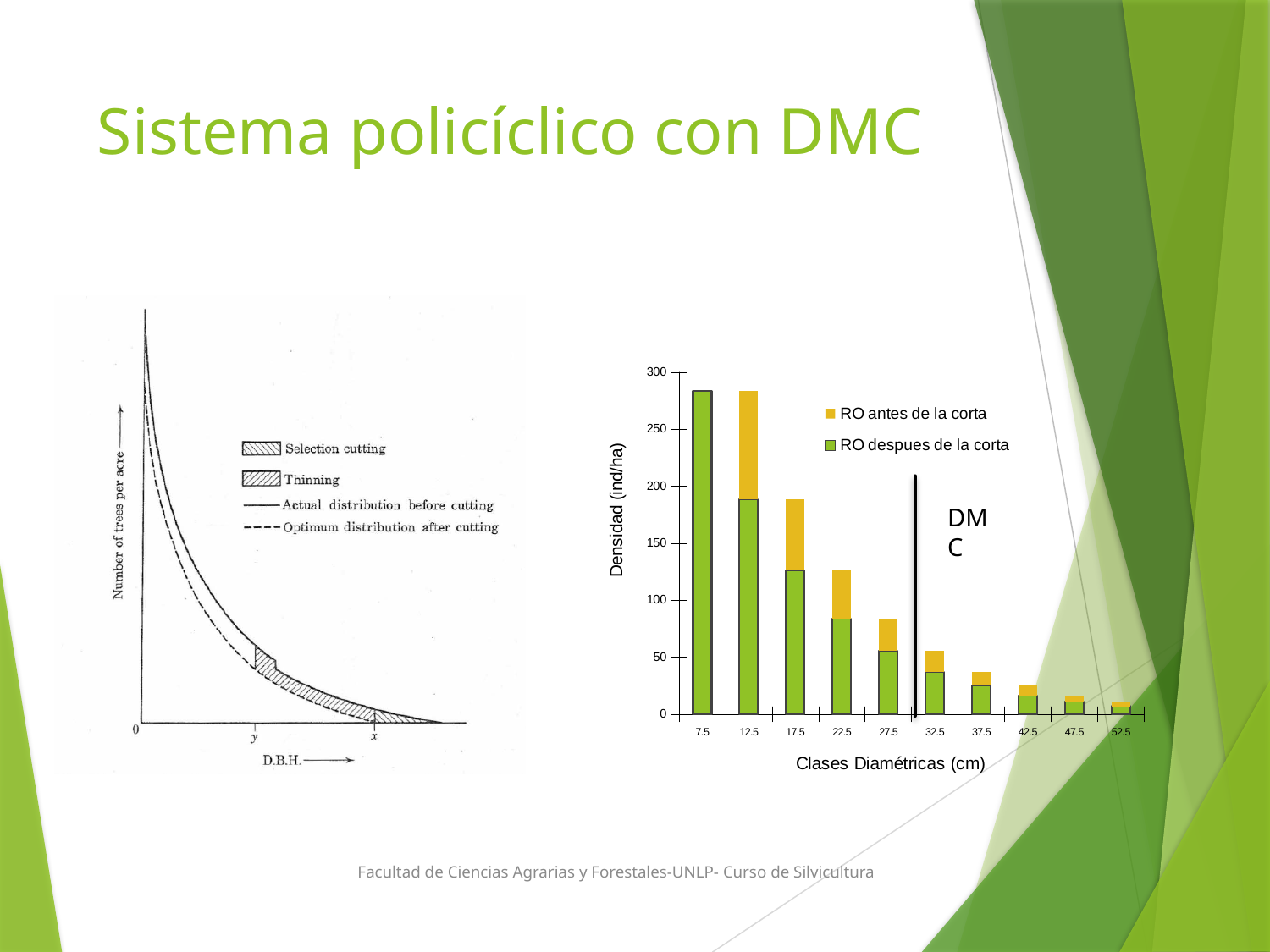
In the right-hand bar chart, is the value of RO despues de la corta for class 32.5 greater or less than 50? less What kind of chart is the chart on the right of the slide? bar chart In the right-hand bar chart, is the value of RO despues de la corta for class 12.5 greater or less than 150? greater In the left-hand chart, what does the dashed line represent according to its legend? Optimum distribution after cutting In the right-hand bar chart, which diameter class has the lowest total density? 52.5 In the right-hand bar chart, do the bar heights rise or fall as the diameter class increases along the x axis? fall How many diameter classes are shown on the x axis of the right-hand bar chart? 10 In the right-hand bar chart, is the value of RO despues de la corta for class 17.5 greater or less than 150? less In the right-hand bar chart, which diameter class has the highest density after cutting (RO despues de la corta)? 7.5 In the right-hand bar chart, which is larger: RO despues de la corta for class 12.5 or for class 17.5? 12.5 What is the y-axis label of the right-hand bar chart? Densidad (ind/ha) How many series does the legend of the right-hand bar chart list? 2